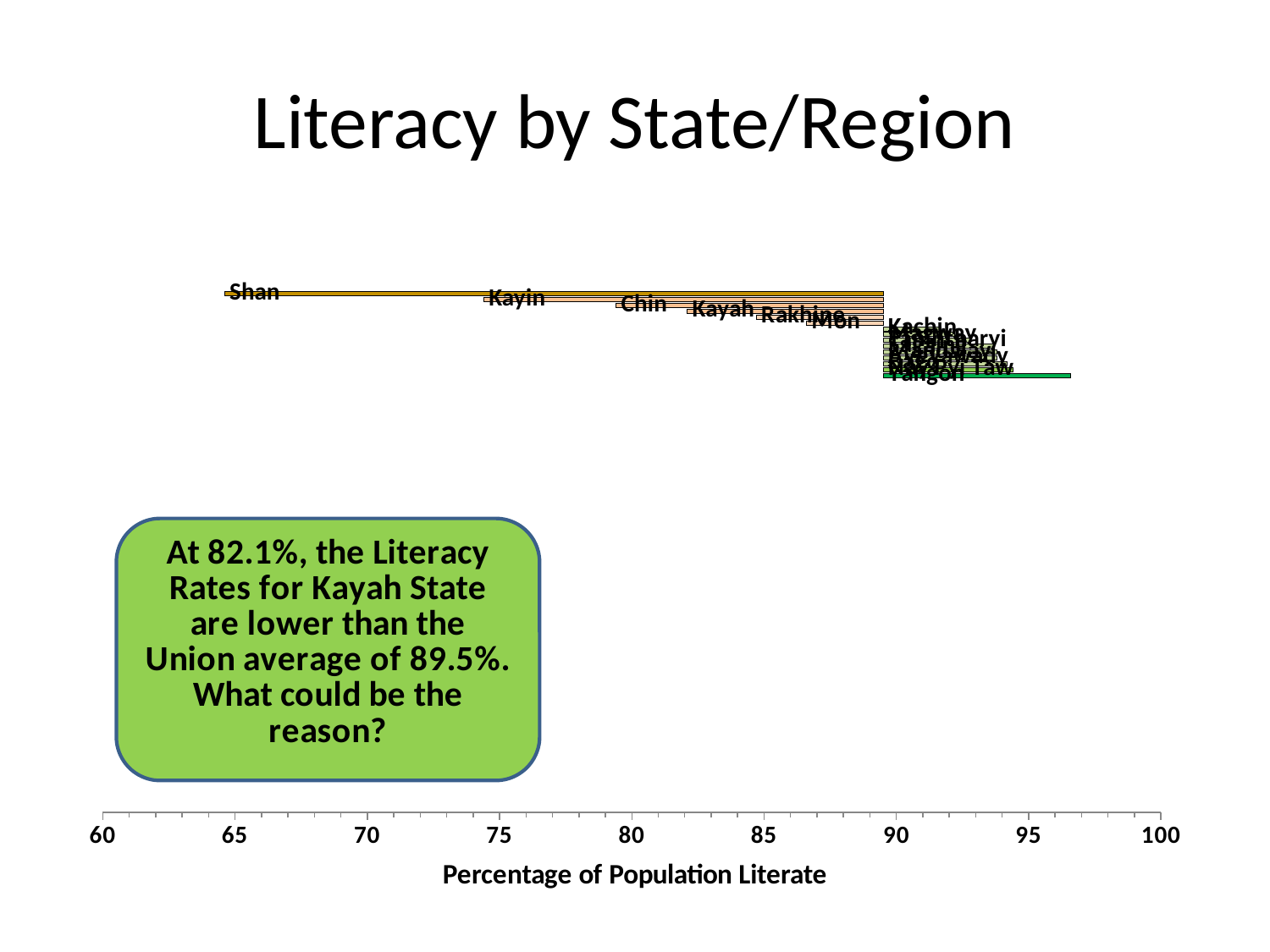
Which state or region has the lowest literacy rate in the chart? Shan By how many percentage points is Kayah State's literacy rate below the Union average? 7.4 What is the title of the chart? Literacy by State/Region Is the literacy rate for Kayin greater or less than 70? greater What kind of chart is shown on the slide? bar chart Which has the higher literacy rate, Shan or Kayin? Kayin Is the literacy rate for Shan greater or less than 70? less Is the literacy rate for Chin greater or less than 75? greater What is the literacy rate for Kayah State? 82.1% What is the label of the horizontal axis? Percentage of Population Literate What is the Union average literacy rate stated on the slide? 89.5%